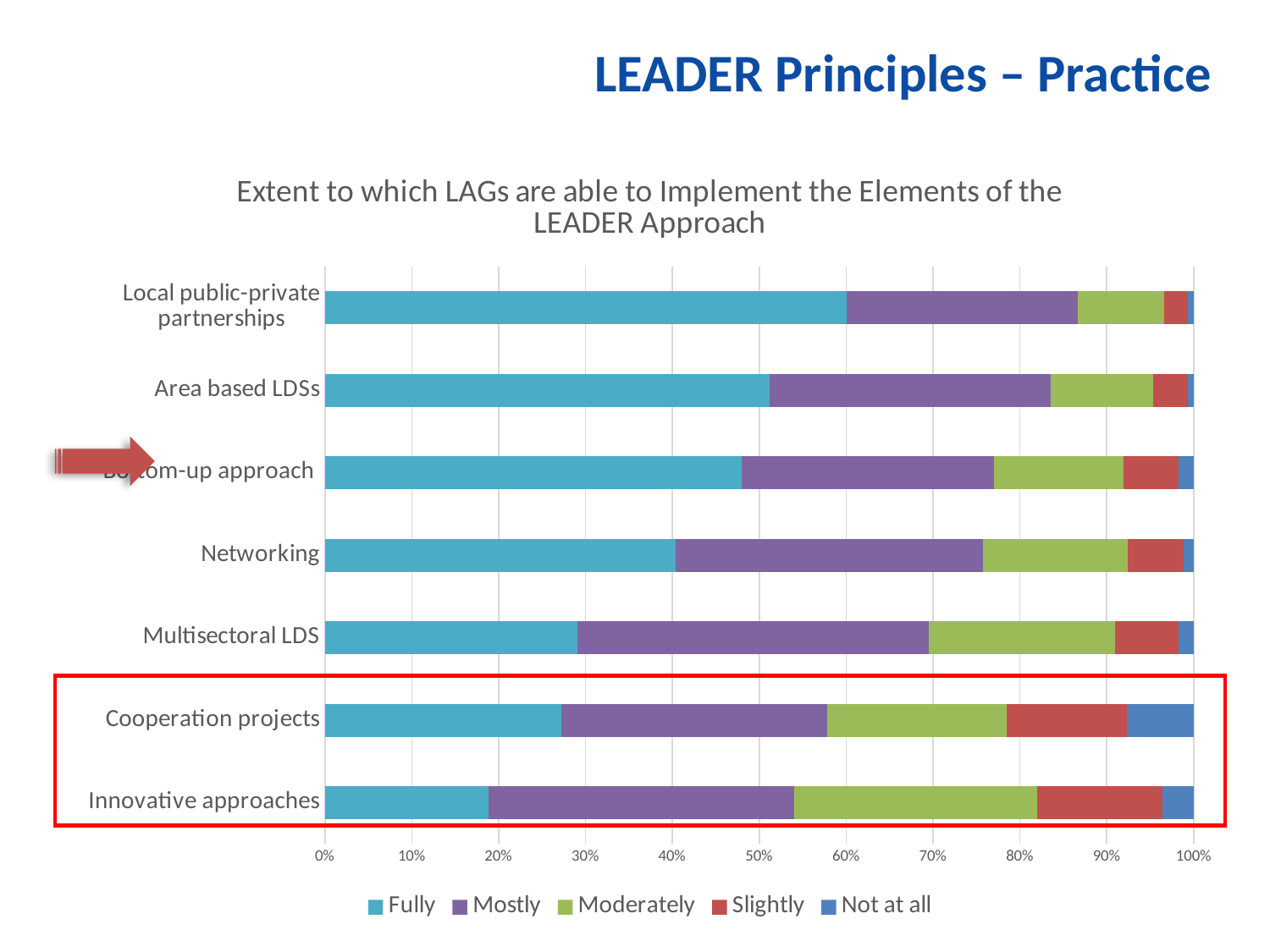
Which has a larger 'Moderately' segment, Innovative approaches or Area based LDSs? Innovative approaches Which category has the largest 'Not at all' segment? Cooperation projects Is the 'Fully' share for Local public-private partnerships greater or less than 50%? greater Is the 'Fully' share for Cooperation projects greater or less than 30%? less Which category has the largest 'Fully' segment? Local public-private partnerships What is the title of the chart? Extent to which LAGs are able to Implement the Elements of the LEADER Approach Which colour represents the 'Fully' series in the chart? Blue (teal) How many categories (LEADER elements) are plotted on the chart? 7 How many series does the legend list? 5 Which category has the smallest 'Fully' segment? Innovative approaches Which has a larger 'Fully' segment, Networking or Multisectoral LDS? Networking What kind of chart is shown on the slide? Stacked bar chart